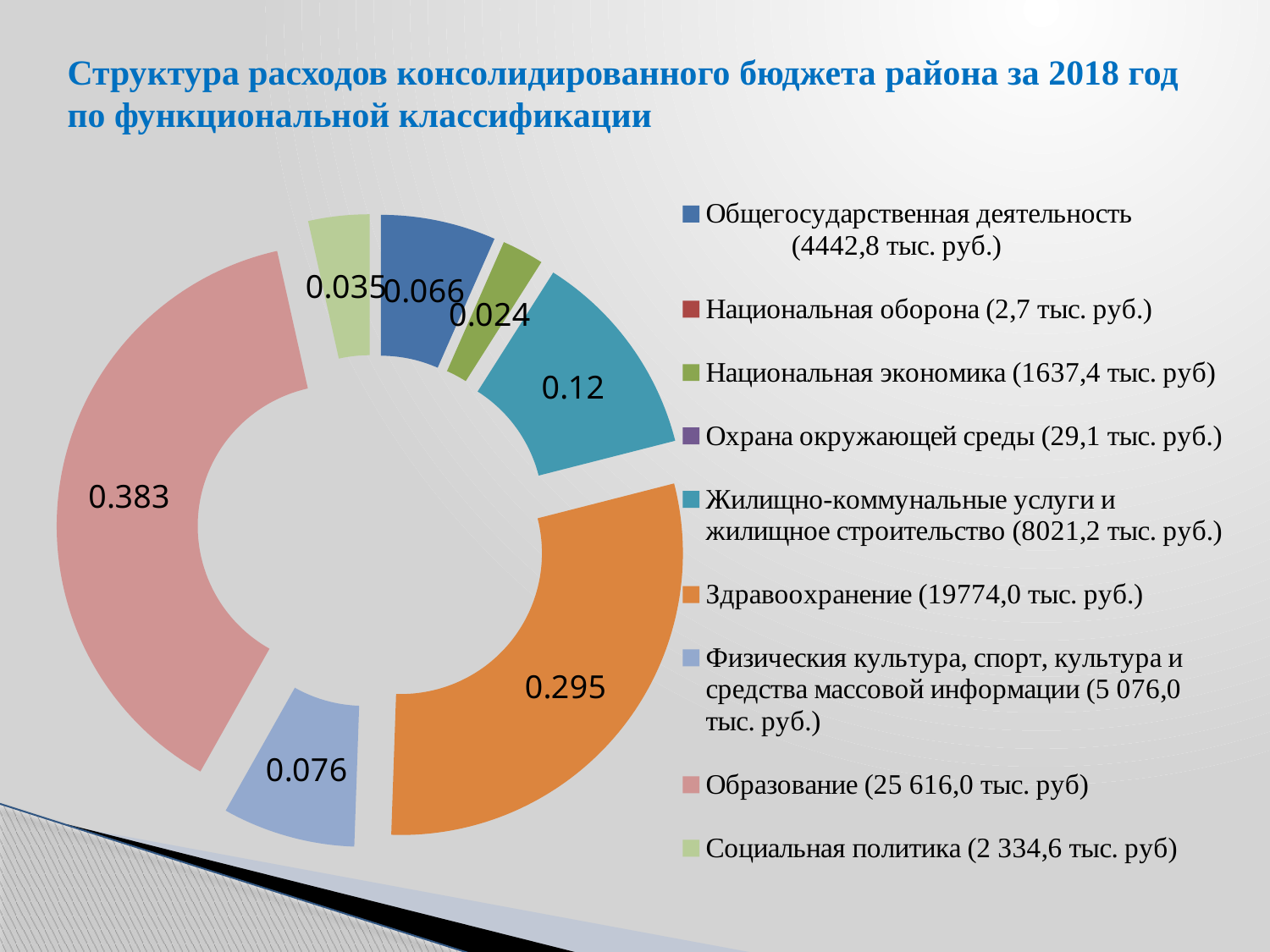
How many categories does the legend list? 9 What amount in тыс. руб. does the legend give for Образование? 25 616,0 тыс. руб What share is shown for Общегосударственная деятельность? 0.066 Which has the larger share: Здравоохранение or Жилищно-коммунальные услуги и жилищное строительство? Здравоохранение What share is shown for Образование? 0.383 What kind of chart is shown on the slide? Doughnut (pie) chart What share is shown for Социальная политика? 0.035 What share is shown for Жилищно-коммунальные услуги и жилищное строительство? 0.12 What share is shown for Здравоохранение? 0.295 Which category has the largest share of the chart? Образование What colour is the slice for Здравоохранение? Orange What is the difference between the shares for Образование and Здравоохранение? 0.088